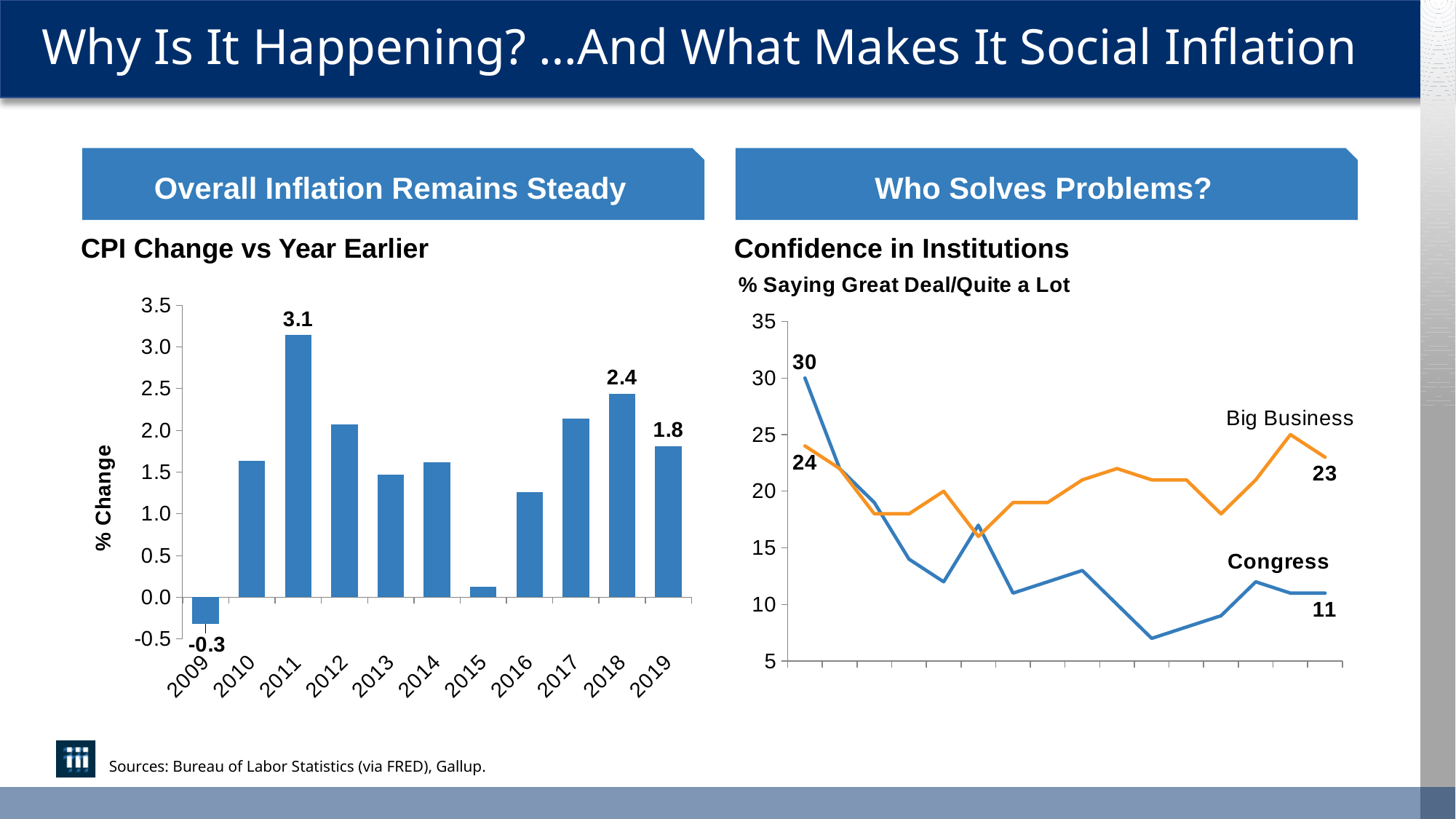
In the Confidence in Institutions chart, what is the final value for Big Business? 23 In the CPI Change vs Year Earlier chart, what is the value for 2011? 3.1 In the CPI Change vs Year Earlier chart, which year has the lowest value? 2009 In the CPI Change vs Year Earlier chart, what is the value for 2019? 1.8 In the CPI Change vs Year Earlier chart, what is the difference between the 2018 and 2019 values? 0.6 In the CPI Change vs Year Earlier chart, is the value for 2015 greater or less than 0.5? less In the CPI Change vs Year Earlier chart, which year has the highest value? 2011 In the Confidence in Institutions chart, which series has the higher starting value, Big Business or Congress? Congress In the Confidence in Institutions chart, what is the final value for Congress? 11 In the CPI Change vs Year Earlier chart, how many years are shown on the x axis? 11 What kind of chart is the CPI Change vs Year Earlier chart? bar chart In the CPI Change vs Year Earlier chart, what is the value for 2009? -0.3